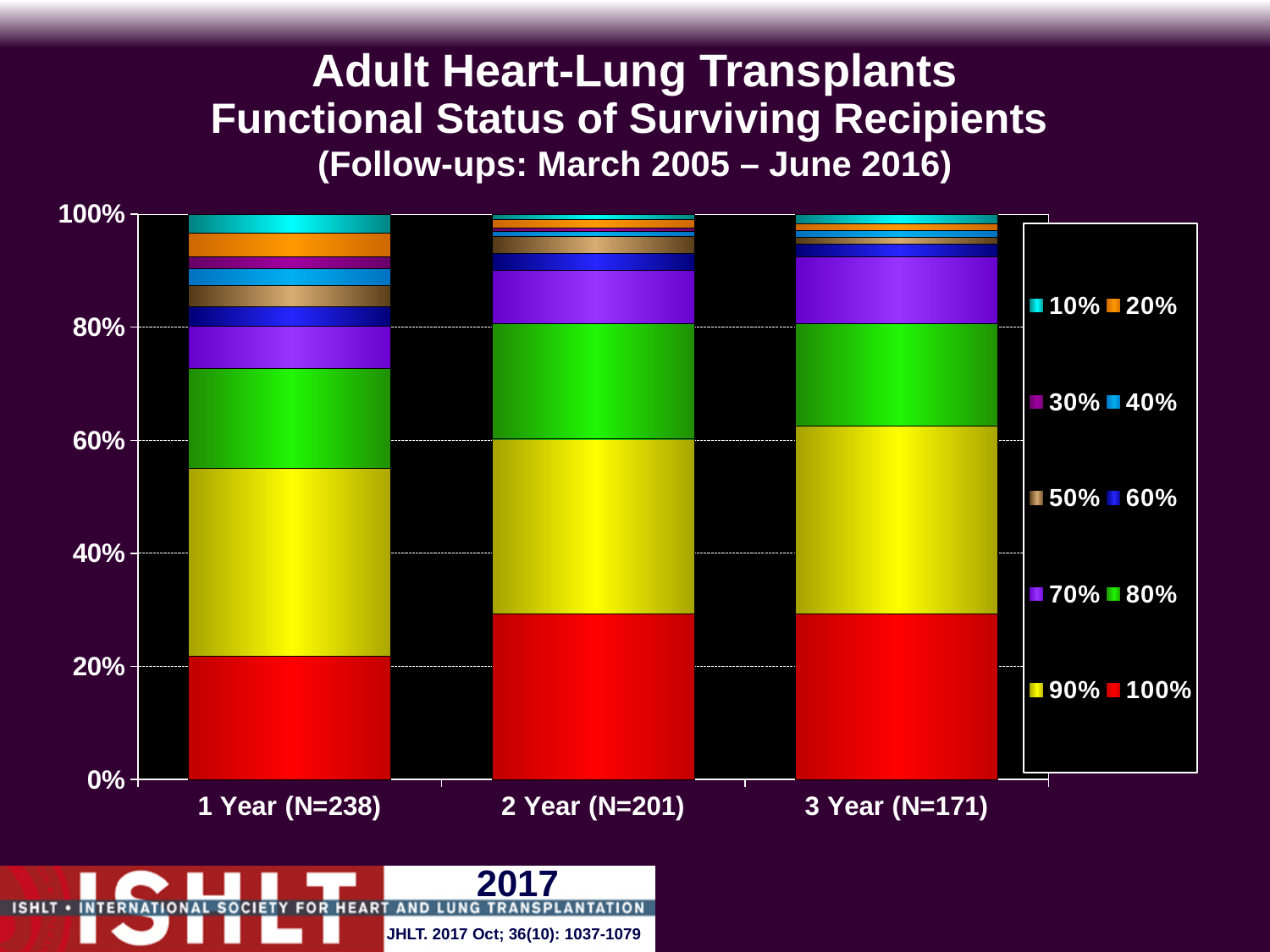
Is the share of recipients at 100% functional status at 2 Year greater or less than 20%? greater Is the share of recipients at 100% functional status at 1 Year greater or less than 40%? less What kind of chart is shown on the slide? Stacked bar chart What is the sample size (N) shown for the 3 Year category? 171 What is the sample size (N) shown for the 1 Year category? 238 What is the total of the stacked bar for 3 Year (N=171)? 100% Which has the larger share of recipients at 100% functional status, 1 Year or 2 Year? 2 Year (N=201) Which follow-up time point has the smallest share of recipients at 100% functional status (red segment)? 1 Year (N=238) How many follow-up time points (categories) are shown on the x axis? 3 How many series does the legend list? 10 Is the combined share of recipients at 90% and 100% functional status at 1 Year greater or less than 60%? less Does the share of recipients at 100% functional status rise or fall from 1 Year to 2 Year? rise